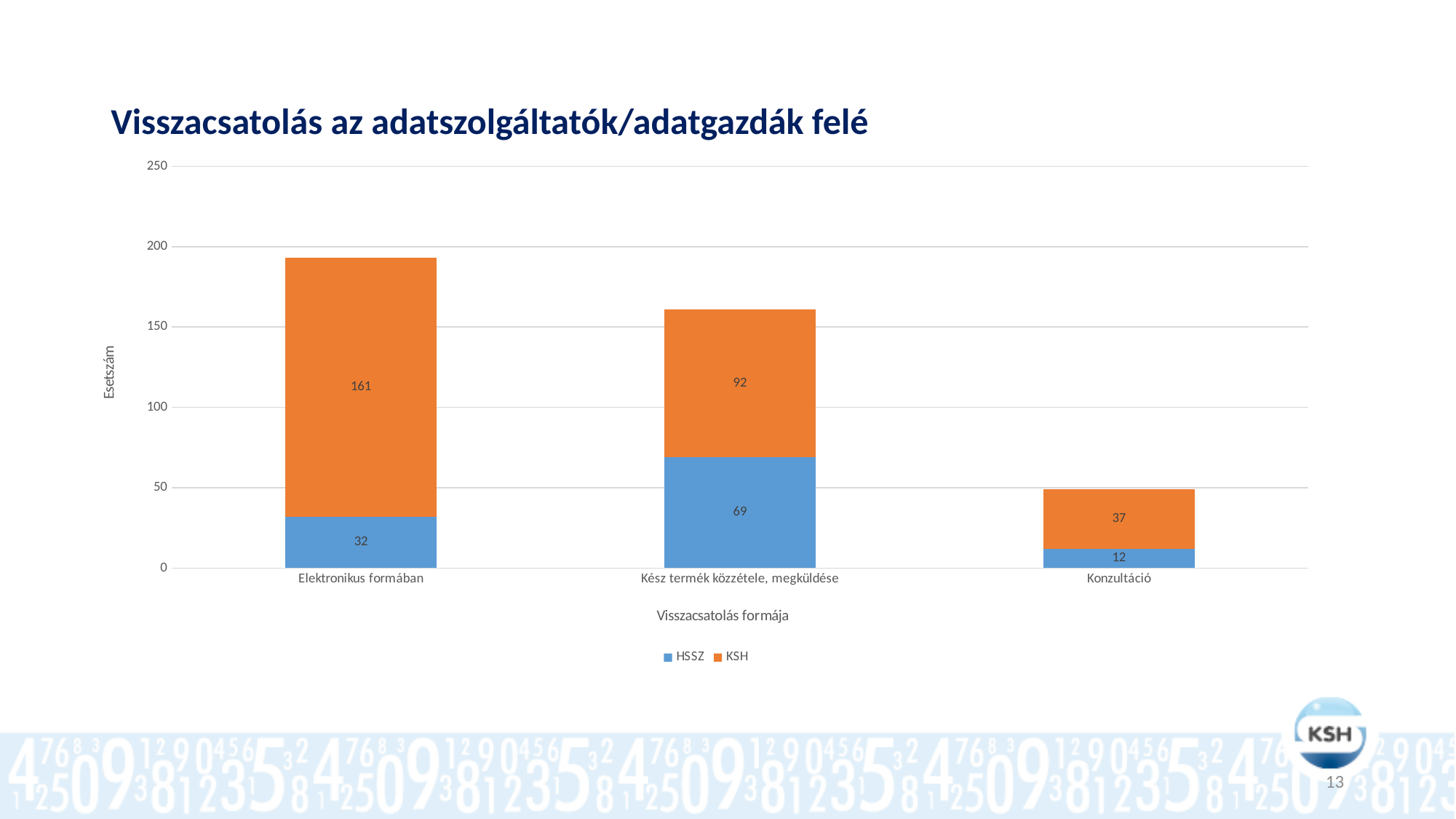
What is the HSSZ value for Kész termék közzétele, megküldése? 69 What is the KSH value for Konzultáció? 37 What is the difference between the KSH values for Elektronikus formában and Kész termék közzétele, megküldése? 69 What is the KSH value for Elektronikus formában? 161 How many series does the legend list? 2 Which category has the lowest HSSZ value? Konzultáció Which is larger: the HSSZ value for Kész termék közzétele, megküldése or the HSSZ value for Elektronikus formában? Kész termék közzétele, megküldése What is the total of the stacked bar for Konzultáció? 49 What is the HSSZ value for Konzultáció? 12 What kind of chart is shown on the slide? Stacked bar chart Which category has the highest KSH value? Elektronikus formában How many categories are shown on the x axis? 3